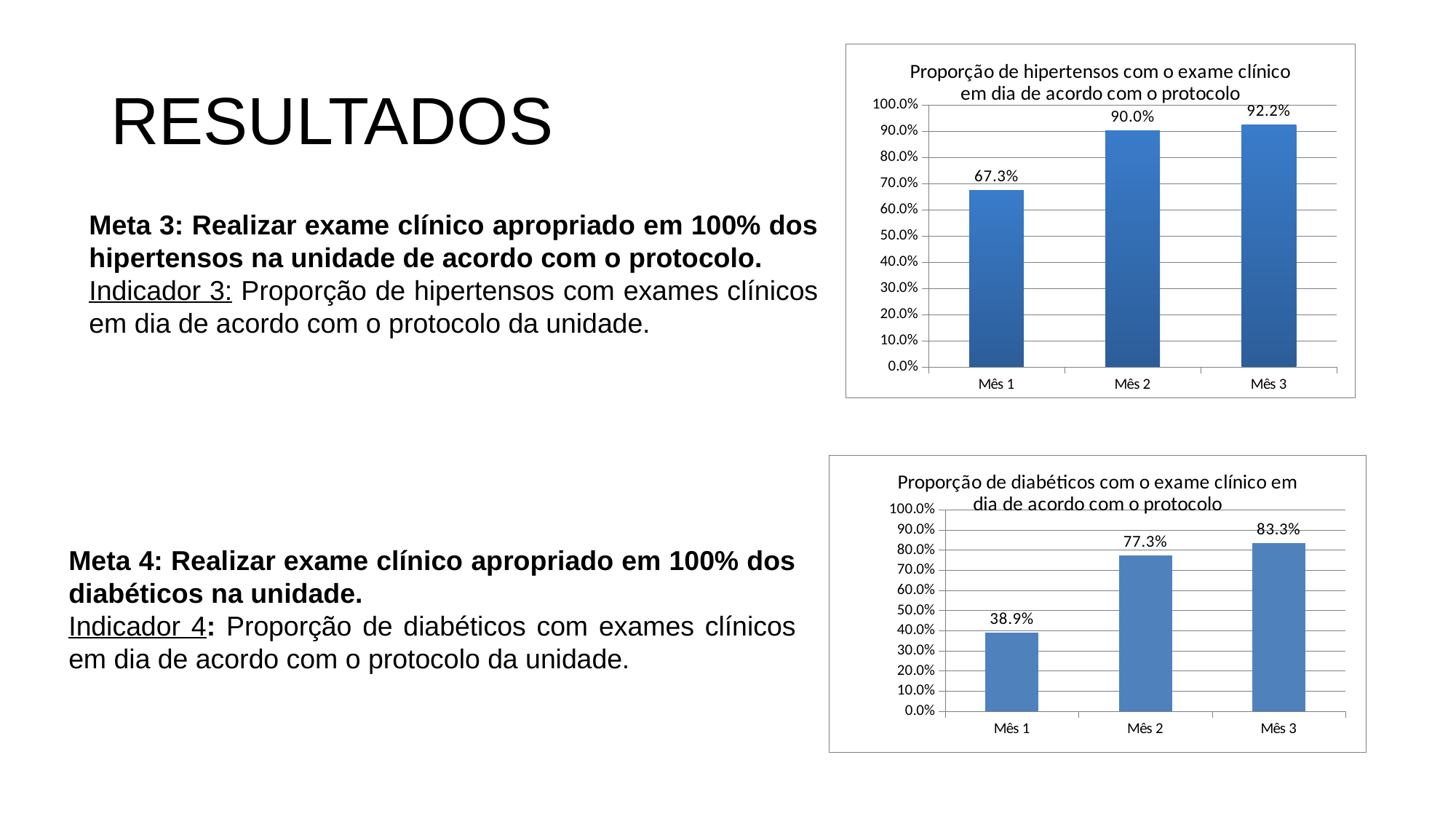
In the top chart (Proporção de hipertensos), do the values rise or fall from Mês 1 to Mês 3? rise In the bottom chart (Proporção de diabéticos), what is the value for Mês 2? 77.3% In the bottom chart (Proporção de diabéticos), is the value for Mês 1 greater or less than 40.0%? less In the top chart (Proporção de hipertensos com o exame clínico em dia de acordo com o protocolo), what is the value for Mês 1? 67.3% What kind of chart is the top chart (Proporção de hipertensos)? bar chart In the top chart (Proporção de hipertensos), what is the difference between Mês 2 and Mês 1? 22.7% In the bottom chart (Proporção de diabéticos com o exame clínico em dia de acordo com o protocolo), what is the value for Mês 1? 38.9% How many months are shown in the bottom chart (Proporção de diabéticos)? 3 In the top chart (Proporção de hipertensos), what is the value for Mês 3? 92.2% In the bottom chart (Proporção de diabéticos), what is the difference between Mês 3 and Mês 1? 44.4% In the top chart (Proporção de hipertensos), which month has the lowest value? Mês 1 In the bottom chart (Proporção de diabéticos), which month has the highest value? Mês 3